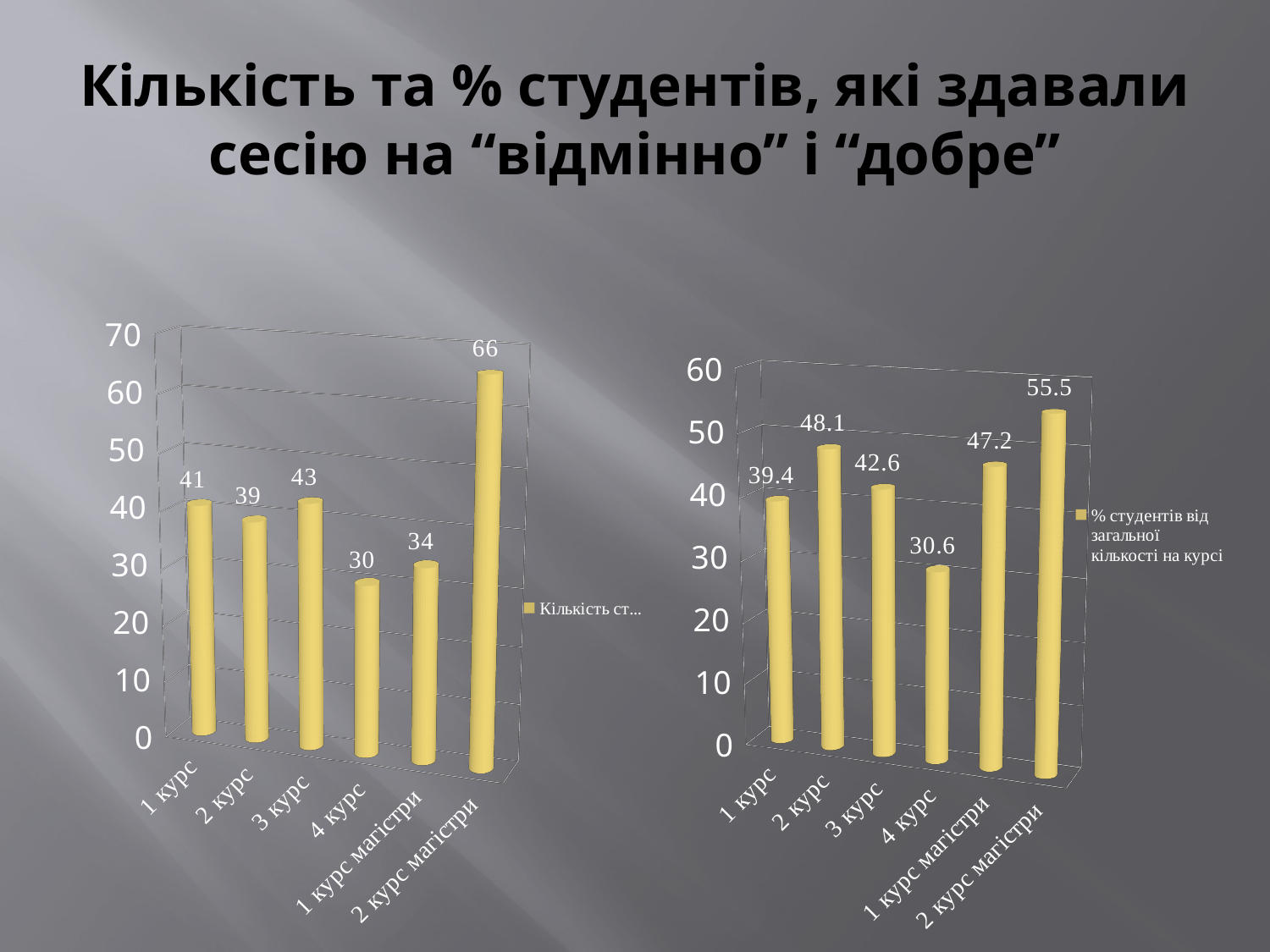
In the right chart, which is larger: the value for 1 курс or the value for 3 курс? 3 курс In the right chart, what is the value for 2 курс? 48.1 In the left chart, what is the value for 4 курс? 30 How many categories are shown on the x axis of the left chart? 6 In the right chart, what is the value for 1 курс магістри? 47.2 What is the legend entry of the right chart? % студентів від загальної кількості на курсі In the left chart, which category has the highest value? 2 курс магістри In the left chart, what is the difference between the values for 3 курс and 2 курс? 4 In the right chart, what is the difference between the values for 2 курс магістри and 4 курс? 24.9 In the right chart, which category has the lowest value? 4 курс In the left chart, what is the value for 2 курс магістри? 66 What kind of chart is the right chart? bar chart